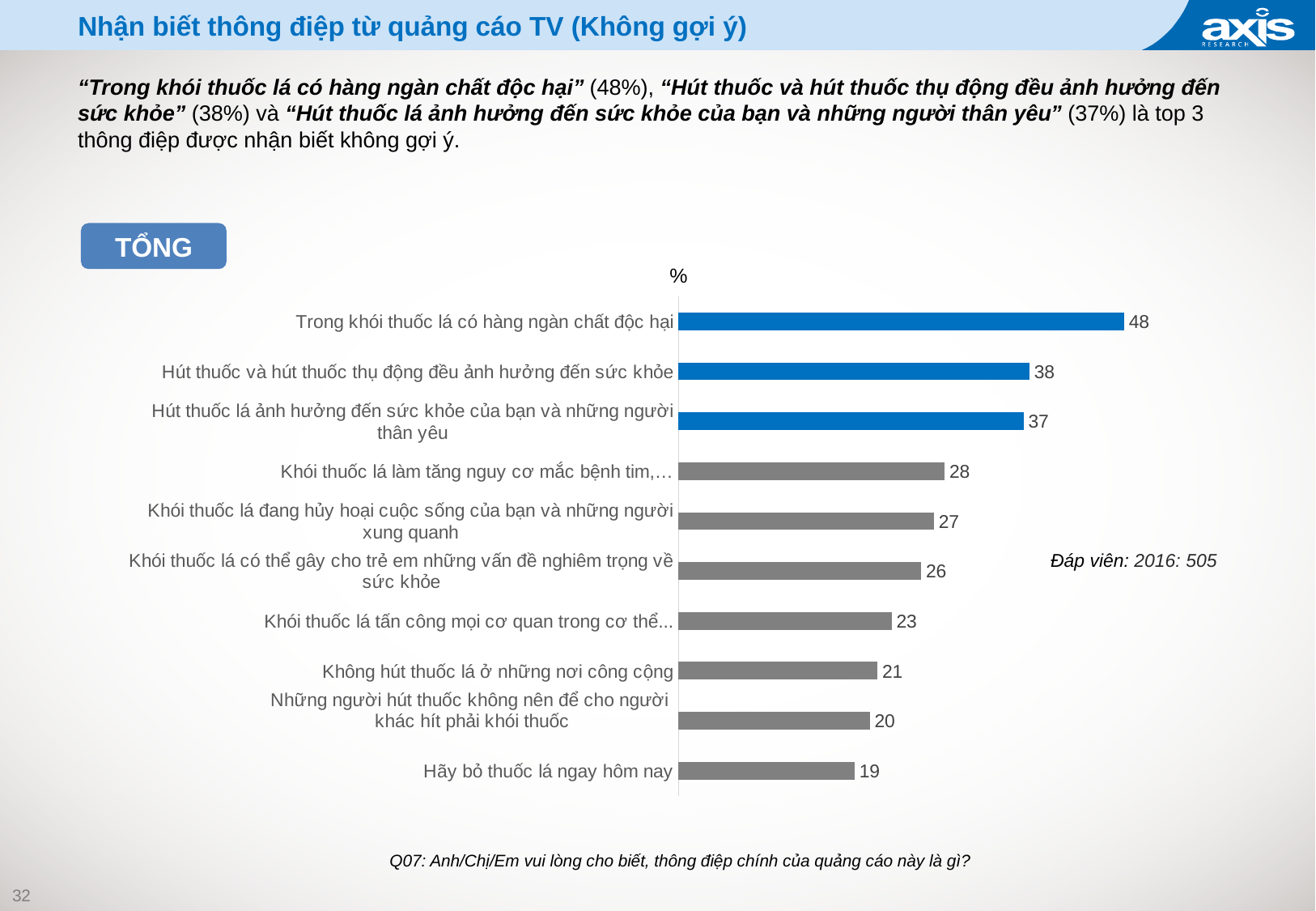
Which category has the lowest value? Hãy bỏ thuốc lá ngay hôm nay What is the difference between the values for "Khói thuốc lá đang hủy hoại cuộc sống của bạn và những người xung quanh" and "Hãy bỏ thuốc lá ngay hôm nay"? 8 What is the value for "Những người hút thuốc không nên để cho người khác hít phải khói thuốc"? 20 What is the difference between the values for "Trong khói thuốc lá có hàng ngàn chất độc hại" and "Hút thuốc và hút thuốc thụ động đều ảnh hưởng đến sức khỏe"? 10 What is the value for "Hãy bỏ thuốc lá ngay hôm nay"? 19 How many categories are shown in the chart? 10 How many bars are coloured blue rather than grey? 3 What kind of chart is shown on the slide? Bar chart What is the value for "Không hút thuốc lá ở những nơi công cộng"? 21 What is the value for "Trong khói thuốc lá có hàng ngàn chất độc hại"? 48 Which is larger: the value for "Khói thuốc lá làm tăng nguy cơ mắc bệnh tim,…" or the value for "Khói thuốc lá tấn công mọi cơ quan trong cơ thể..."? Khói thuốc lá làm tăng nguy cơ mắc bệnh tim,… Which category has the highest value? Trong khói thuốc lá có hàng ngàn chất độc hại